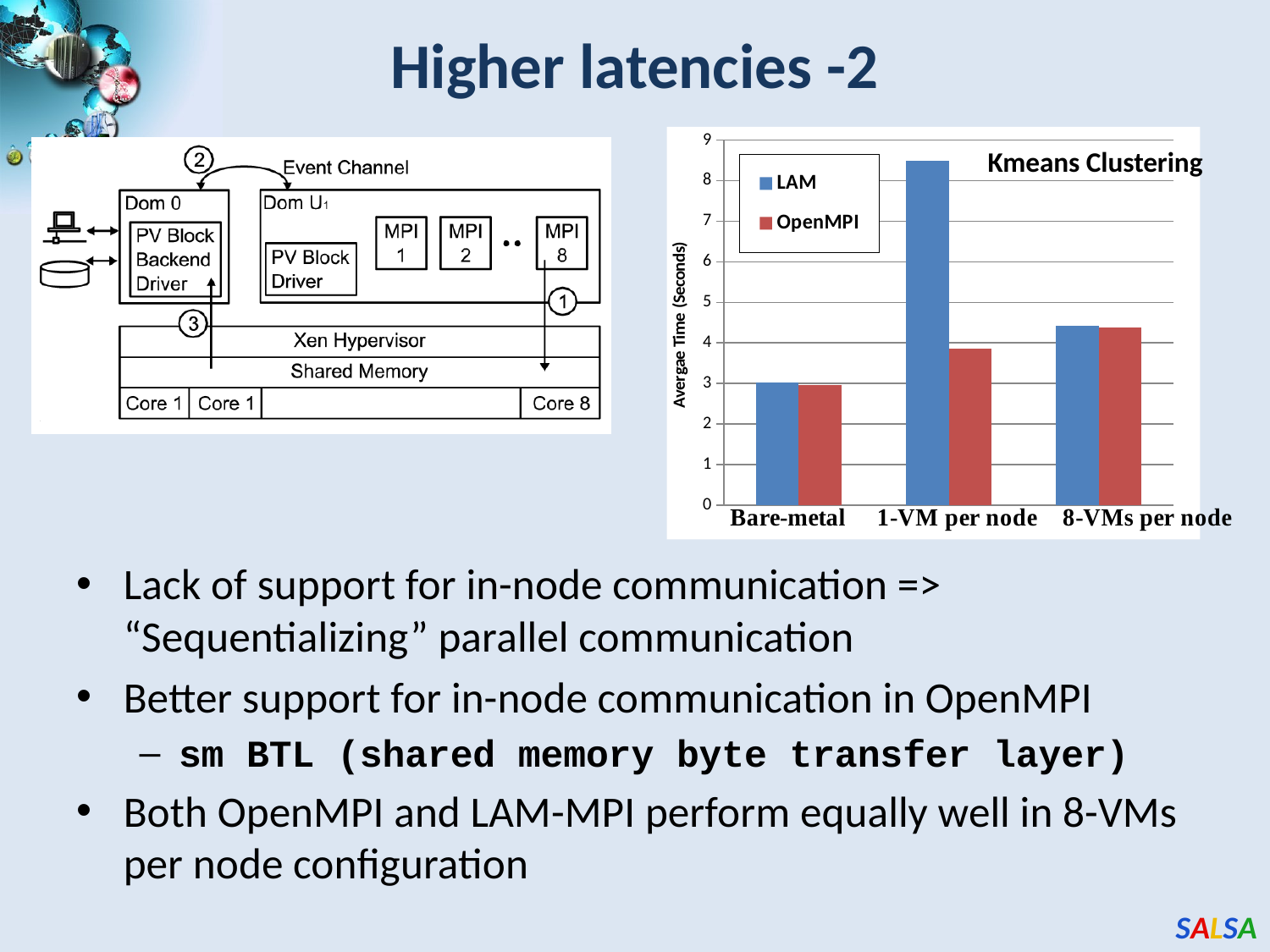
In the Kmeans Clustering chart, is the LAM value for 1-VM per node greater or less than 8? greater In the Kmeans Clustering chart, which category has the highest LAM value? 1-VM per node How many series does the legend of the Kmeans Clustering chart list? 2 What is the title of the bar chart on the slide? Kmeans Clustering In the Kmeans Clustering chart, is the LAM value for Bare-metal greater or less than 4? less In the Kmeans Clustering chart, for 1-VM per node, which is larger: LAM or OpenMPI? LAM What kind of chart is the Kmeans Clustering chart? bar chart In the Kmeans Clustering chart, is the OpenMPI value for 1-VM per node greater or less than 4? less In the Kmeans Clustering chart, which category has the lowest OpenMPI value? Bare-metal In the Kmeans Clustering chart, which category has the lowest LAM value? Bare-metal How many categories are shown on the x axis of the Kmeans Clustering chart? 3 In the Kmeans Clustering chart, which category has the highest OpenMPI value? 8-VMs per node